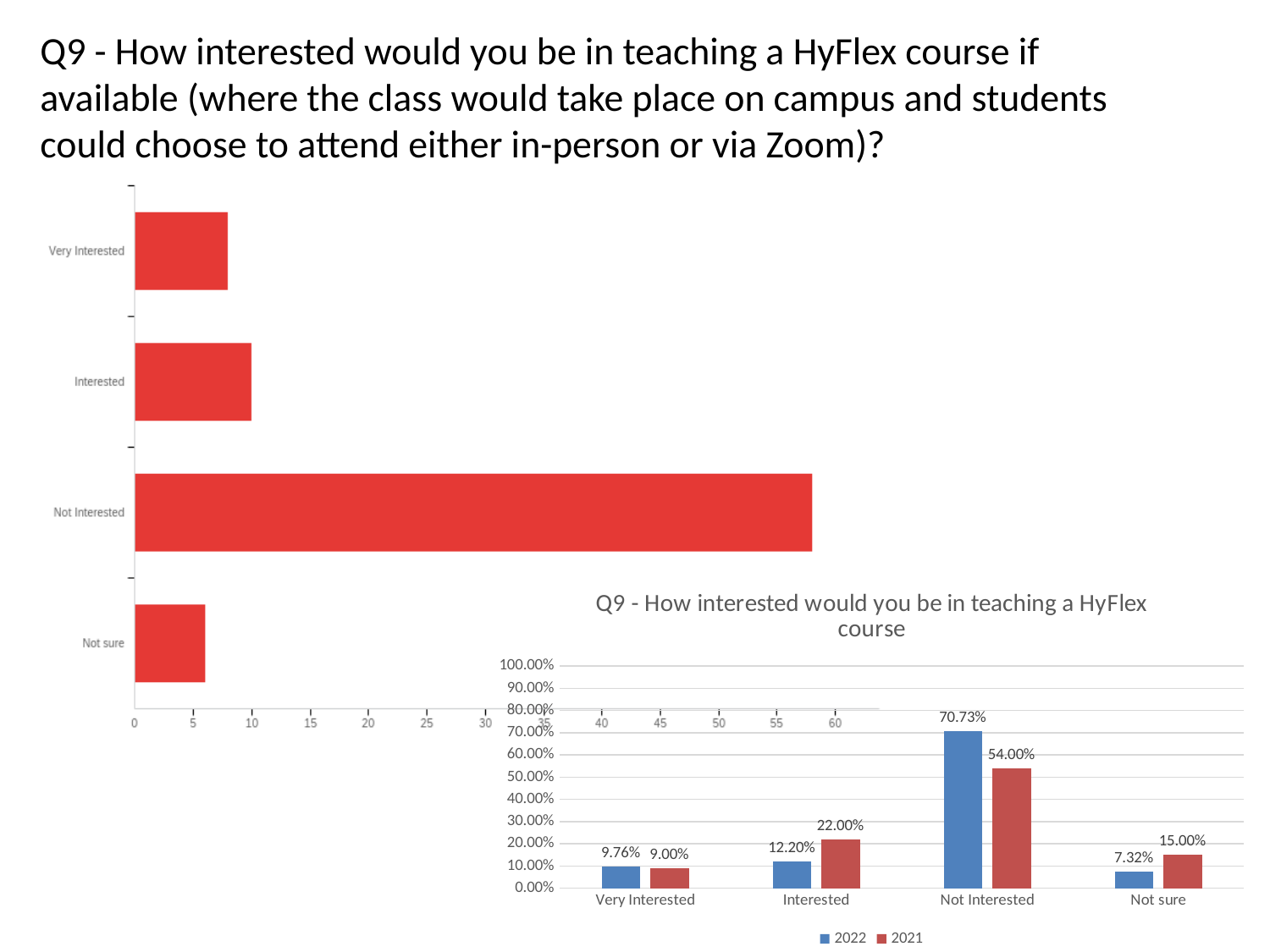
In the clustered bar chart titled 'Q9 - How interested would you be in teaching a HyFlex course', what is the 2021 value for Not sure? 15.00% In the red horizontal bar chart on the left of the slide, is the value for Not Interested greater or less than 50? greater In the clustered bar chart titled 'Q9 - How interested would you be in teaching a HyFlex course', which is larger for Not sure: the 2022 value or the 2021 value? 2021 In the clustered bar chart titled 'Q9 - How interested would you be in teaching a HyFlex course', how many series does the legend list? 2 In the clustered bar chart titled 'Q9 - How interested would you be in teaching a HyFlex course', which category has the lowest 2021 value? Very Interested In the clustered bar chart titled 'Q9 - How interested would you be in teaching a HyFlex course', which category has the highest 2022 value? Not Interested In the clustered bar chart titled 'Q9 - How interested would you be in teaching a HyFlex course', what is the 2021 value for Interested? 22.00% In the clustered bar chart titled 'Q9 - How interested would you be in teaching a HyFlex course', what is the 2022 value for Not Interested? 70.73% What kind of chart is the chart on the left side of the slide with red horizontal bars? Bar chart In the clustered bar chart titled 'Q9 - How interested would you be in teaching a HyFlex course', how many categories are shown on the x axis? 4 In the clustered bar chart titled 'Q9 - How interested would you be in teaching a HyFlex course', what is the difference between the 2022 and 2021 values for Not Interested? 16.73% In the red horizontal bar chart on the left of the slide, is the value for Interested greater or less than 15? less